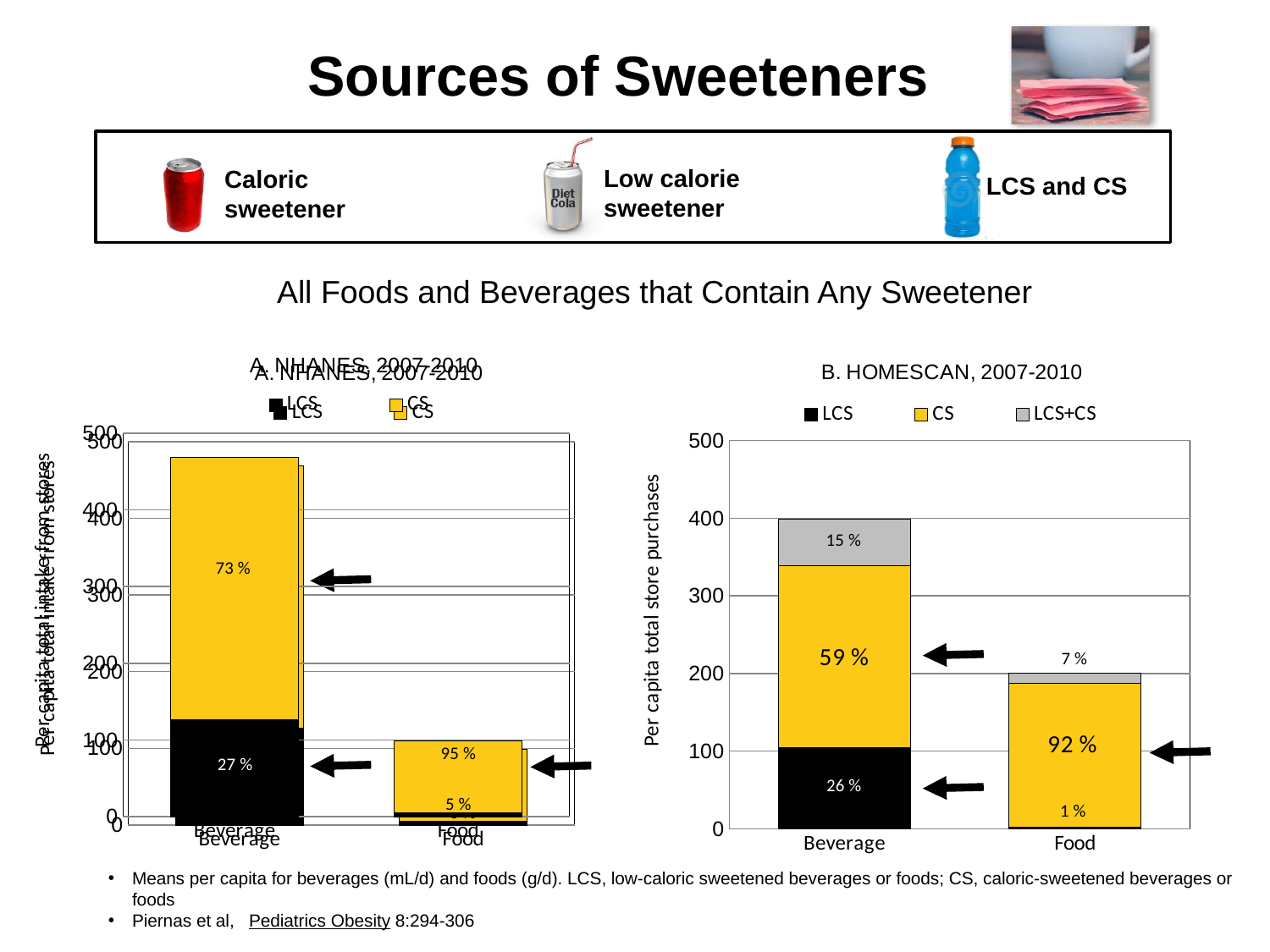
In chart B (HOMESCAN, 2007-2010), is the total value of the Beverage bar greater or less than 300? greater How many series does the legend of chart B (HOMESCAN, 2007-2010) list? 3 How many series does the legend of chart A (NHANES, 2007-2010) list? 2 In chart B (HOMESCAN, 2007-2010), which category has the taller total bar, Beverage or Food? Beverage What kind of chart is chart A (NHANES, 2007-2010)? Stacked bar chart In chart A (NHANES, 2007-2010), what percentage label is shown on the LCS segment of the Beverage bar? 27 % In chart A (NHANES, 2007-2010), what percentage label is shown on the CS segment of the Food bar? 95 % In chart B (HOMESCAN, 2007-2010), what percentage label is shown on the LCS segment of the Food bar? 1 % In chart B (HOMESCAN, 2007-2010), what percentage label is shown on the CS segment of the Beverage bar? 59 % In chart A (NHANES, 2007-2010), is the total value of the Beverage bar greater or less than 400? greater How many categories are shown on the x axis of chart B (HOMESCAN, 2007-2010)? 2 In chart B (HOMESCAN, 2007-2010), what percentage label is shown on the LCS+CS segment of the Beverage bar? 15 %